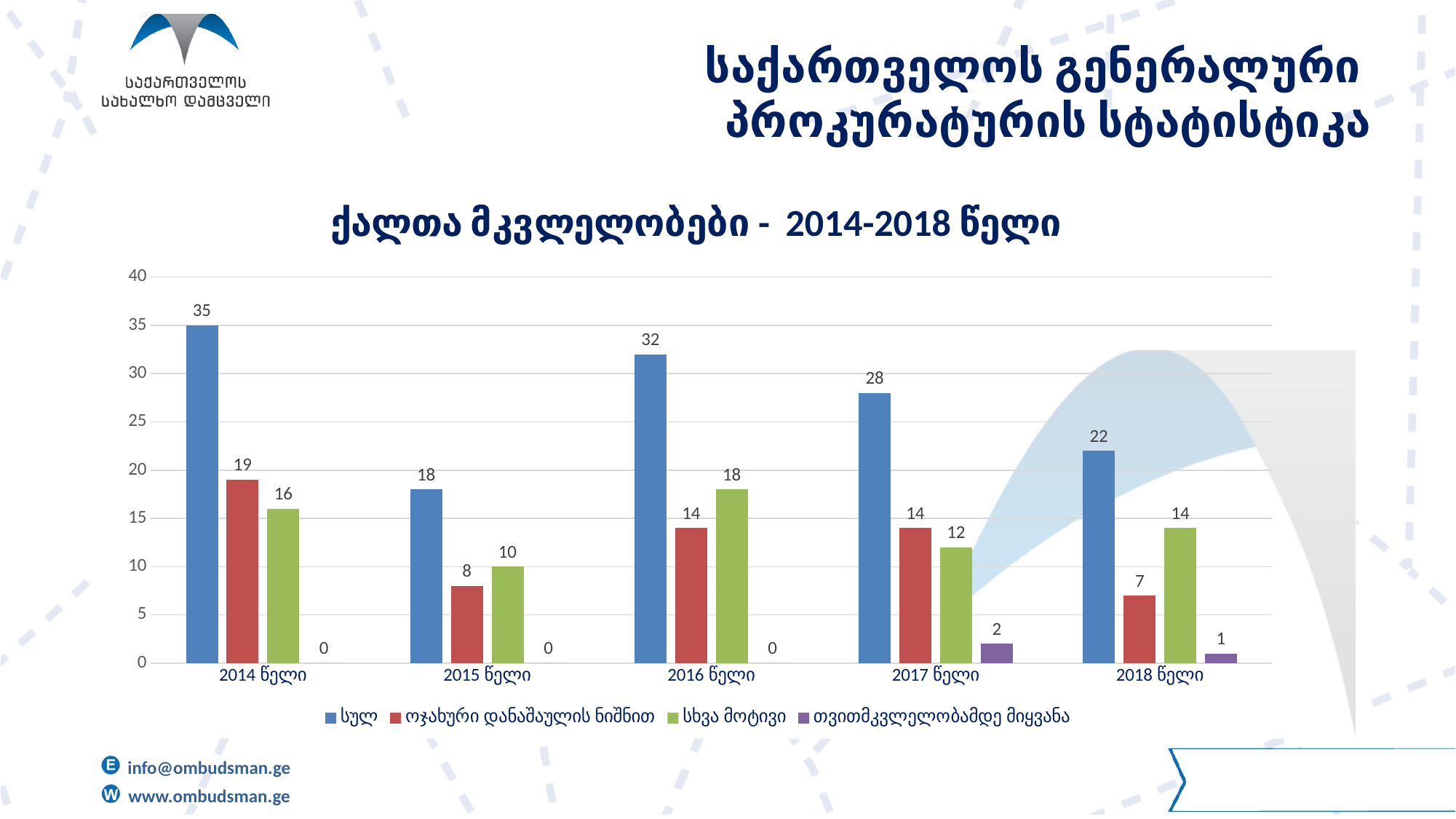
What is the difference between the სულ values for 2016 წელი and 2017 წელი? 4 What is the value of the სხვა მოტივი series for 2016 წელი? 18 How many series does the legend list? 4 What is the value of the სულ series for 2014 წელი? 35 Which is larger for 2015 წელი: ოჯახური დანაშაულის ნიშნით or სხვა მოტივი? სხვა მოტივი In which year is the სულ series lowest? 2015 წელი What is the title of the chart? ქალთა მკვლელობები - 2014-2018 წელი What kind of chart is shown on the slide? Bar chart How many years are shown on the x axis? 5 In which year is the სულ series highest? 2014 წელი What is the value of the ოჯახური დანაშაულის ნიშნით series for 2018 წელი? 7 What is the value of the თვითმკვლელობამდე მიყვანა series for 2017 წელი? 2